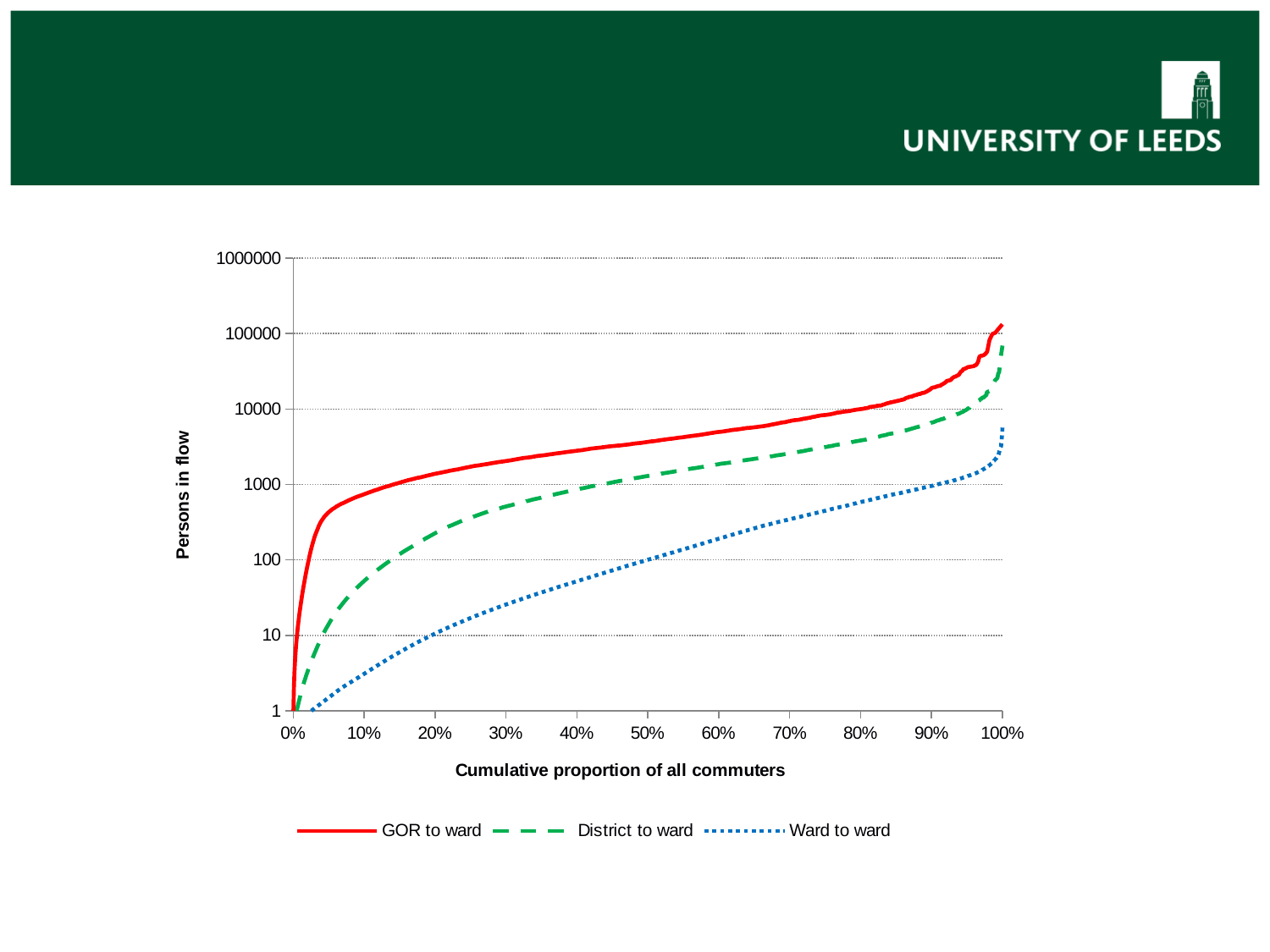
Which series has the lowest values across the chart? Ward to ward Which series has the highest values across the chart? GOR to ward What are the three series named in the legend? GOR to ward, District to ward, Ward to ward Is the value for Ward to ward at 80% cumulative proportion greater or less than 1000? less How many series does the legend list? 3 Is the value for District to ward at 20% cumulative proportion greater or less than 100? greater Is the value for Ward to ward at 40% cumulative proportion greater or less than 100? less At 50% cumulative proportion, which is larger: GOR to ward or Ward to ward? GOR to ward Do the values for each series rise or fall as the cumulative proportion of all commuters increases? rise What is the title of the x axis? Cumulative proportion of all commuters What kind of chart is shown on the slide? line chart